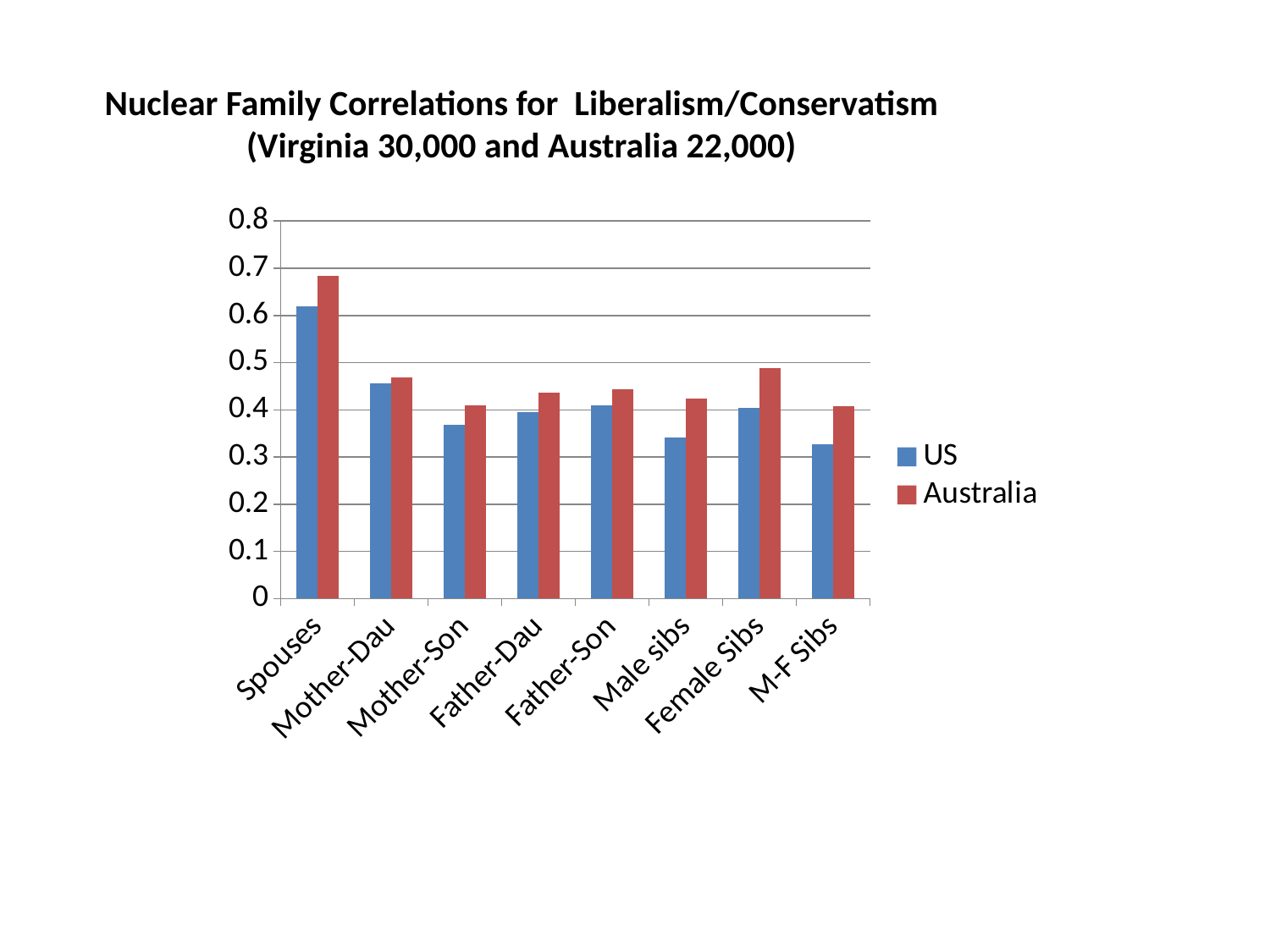
Which category has the highest Australia value? Spouses For Spouses, which is larger: the US value or the Australia value? Australia Which category has the highest US value? Spouses Is the US value for Male sibs greater or less than 0.4? less For Male sibs, which is larger: the US value or the Australia value? Australia Is the Australia value for Spouses greater or less than 0.6? greater Is the Australia value for Female Sibs greater or less than 0.4? greater Which series is shown in red? Australia How many series does the legend list? 2 What kind of chart is shown on the slide? bar chart How many categories are shown on the x axis? 8